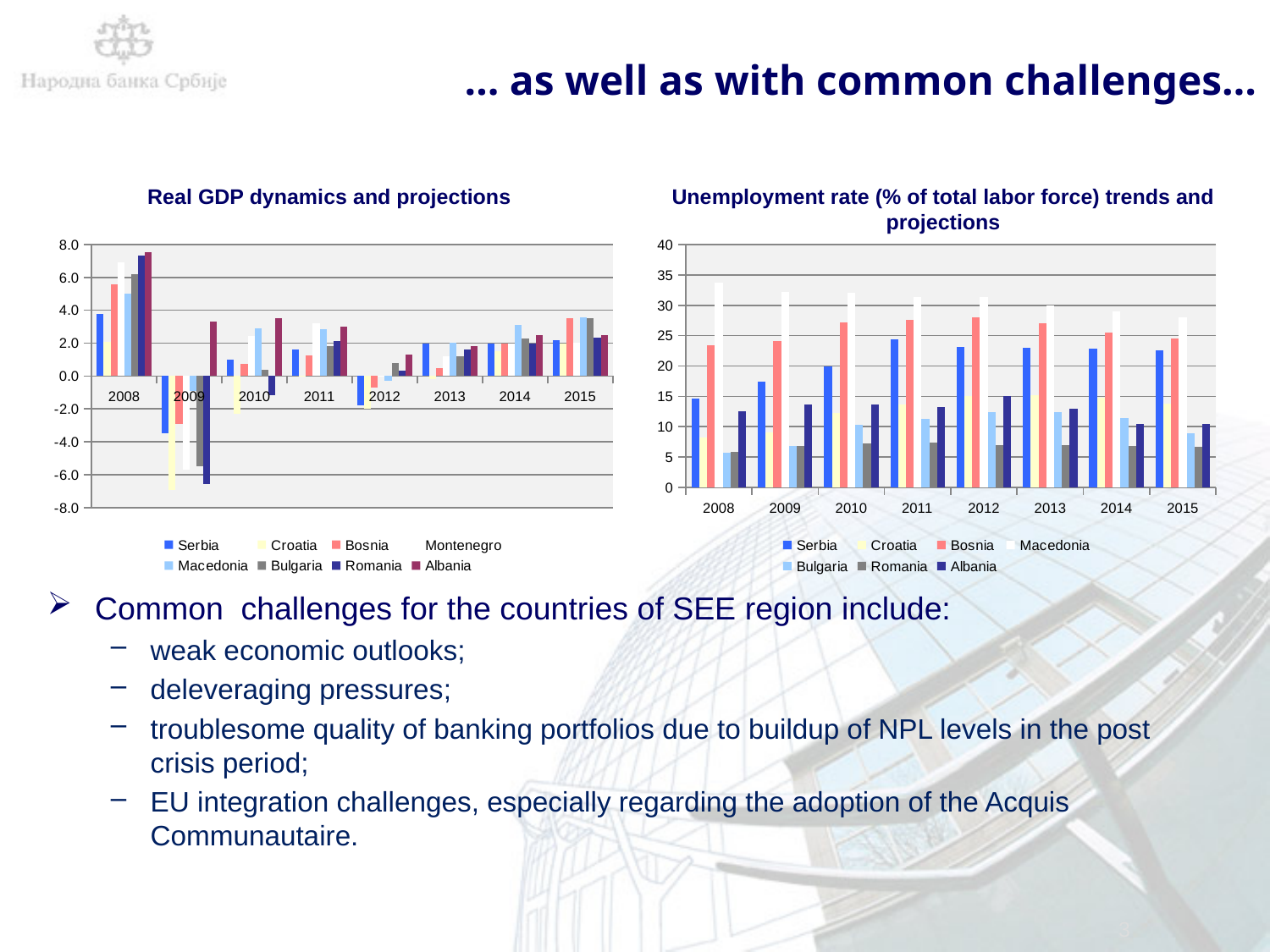
In the 'Real GDP dynamics and projections' chart, which country has the lowest value in 2009? Croatia In the 'Unemployment rate (% of total labor force) trends and projections' chart, which country has the highest unemployment rate in 2008? Macedonia How many series does the legend of the 'Real GDP dynamics and projections' chart list? 8 How many series does the legend of the 'Unemployment rate (% of total labor force) trends and projections' chart list? 7 In the 'Real GDP dynamics and projections' chart, is the value for Croatia in 2009 greater or less than -6.0? less In the 'Unemployment rate (% of total labor force) trends and projections' chart, does Macedonia's unemployment rate rise or fall from 2008 to 2015? fall In the 'Unemployment rate (% of total labor force) trends and projections' chart, is the value for Macedonia in 2008 greater or less than 30? greater What kind of chart is the 'Real GDP dynamics and projections' chart? bar chart How many years are shown on the x axis of the 'Unemployment rate (% of total labor force) trends and projections' chart? 8 In the 'Real GDP dynamics and projections' chart, which is larger in 2009: the value for Albania or the value for Serbia? Albania In the 'Unemployment rate (% of total labor force) trends and projections' chart, is the value for Serbia in 2011 greater or less than 20? greater